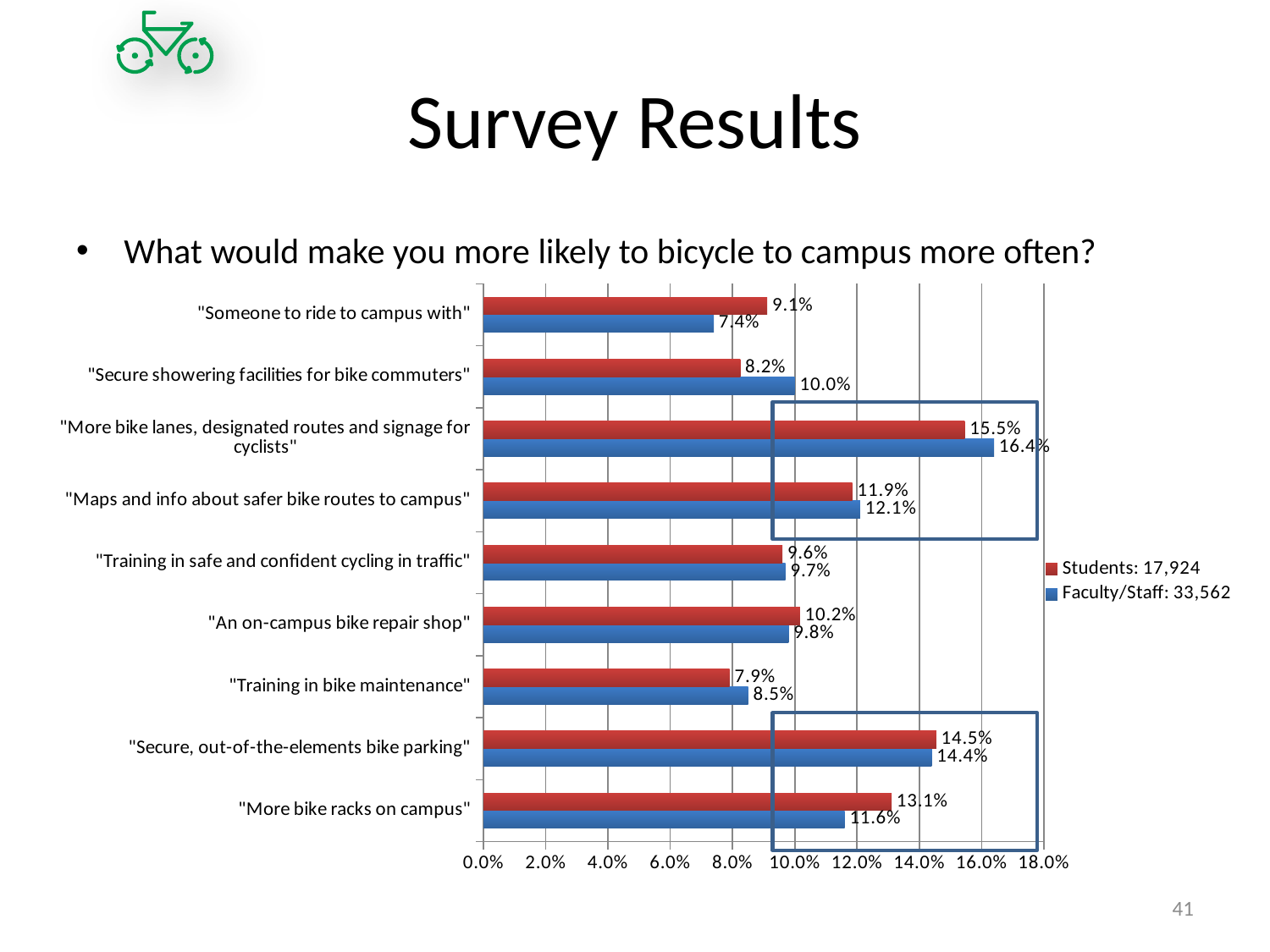
What percentage of Students chose "More bike lanes, designated routes and signage for cyclists"? 15.5% Which colour represents the Students series in the chart? Red How many series does the legend list? 2 Which option has the highest Faculty/Staff percentage? "More bike lanes, designated routes and signage for cyclists" What kind of chart is shown on the slide? Bar chart How many options are listed on the chart? 9 Is the Students value for "Secure, out-of-the-elements bike parking" greater or less than 14.0%? greater What is the difference between the Students and Faculty/Staff values for "Someone to ride to campus with"? 1.7% What percentage of Faculty/Staff chose "Secure showering facilities for bike commuters"? 10.0% Which option has the lowest Students percentage? "Training in bike maintenance" What is the Faculty/Staff value for "More bike racks on campus"? 11.6% For "Secure showering facilities for bike commuters", which group has the larger value, Students or Faculty/Staff? Faculty/Staff